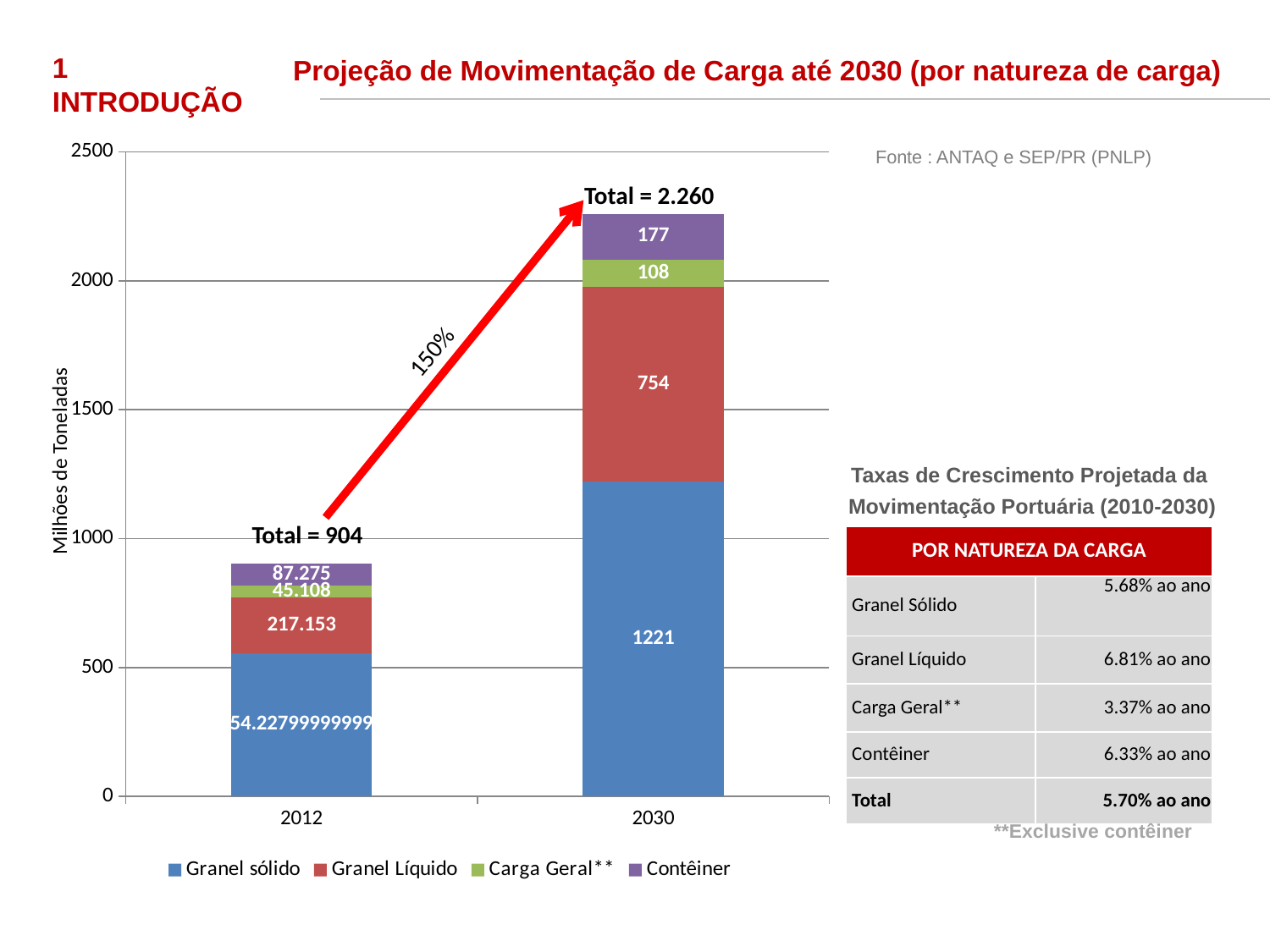
What is the difference between Granel sólido and Granel Líquido in 2030? 467 What kind of chart is shown on the slide? Stacked bar chart How many years are shown on the x axis? 2 What is the label of the y axis? Milhões de Toneladas Which series has the largest value in 2030? Granel sólido How many series does the legend list? 4 What is the total of the stacked bar for 2012? 904 What is the value for Contêiner in 2030? 177 What is the value for Granel Líquido in 2012? 217.153 What is the total of the stacked bar for 2030? 2.260 What is the value for Granel sólido in 2030? 1221 What is the value for Granel Líquido in 2030? 754